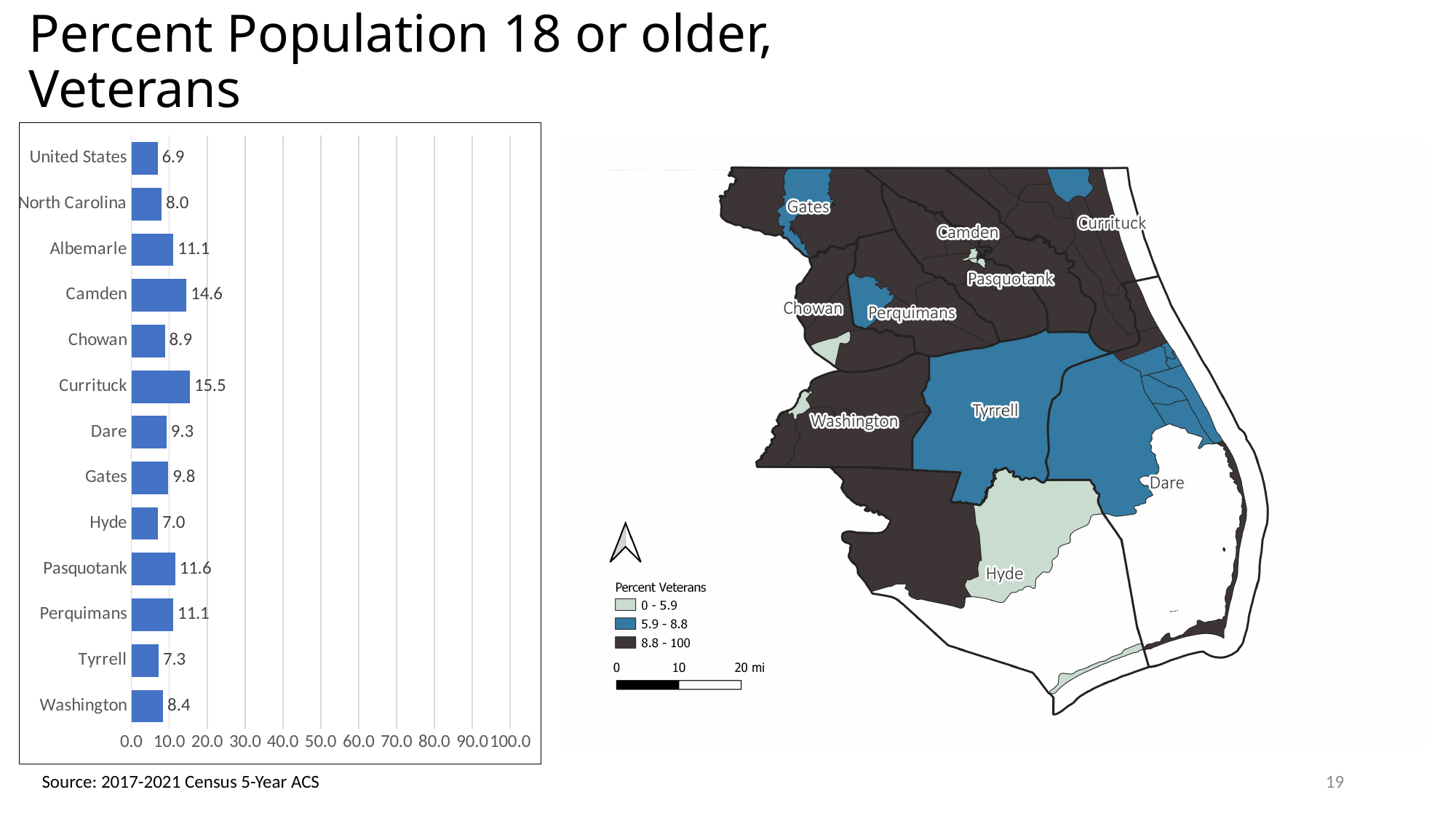
What is the value for Currituck in the bar chart? 15.5 What is the difference between the values for North Carolina and the United States in the bar chart? 1.1 How many categories are shown in the bar chart? 13 Which has a larger value in the bar chart, Pasquotank or Gates? Pasquotank What type of chart is shown on the left of the slide? bar chart What is the value for Hyde in the bar chart? 7.0 Which category has the lowest value in the bar chart? United States Is the value for Washington in the bar chart greater or less than 10.0? less Which category has the highest value in the bar chart? Currituck What is the difference between the values for Currituck and Camden in the bar chart? 0.9 What is the value for Camden in the bar chart? 14.6 What is the value for the United States in the bar chart? 6.9